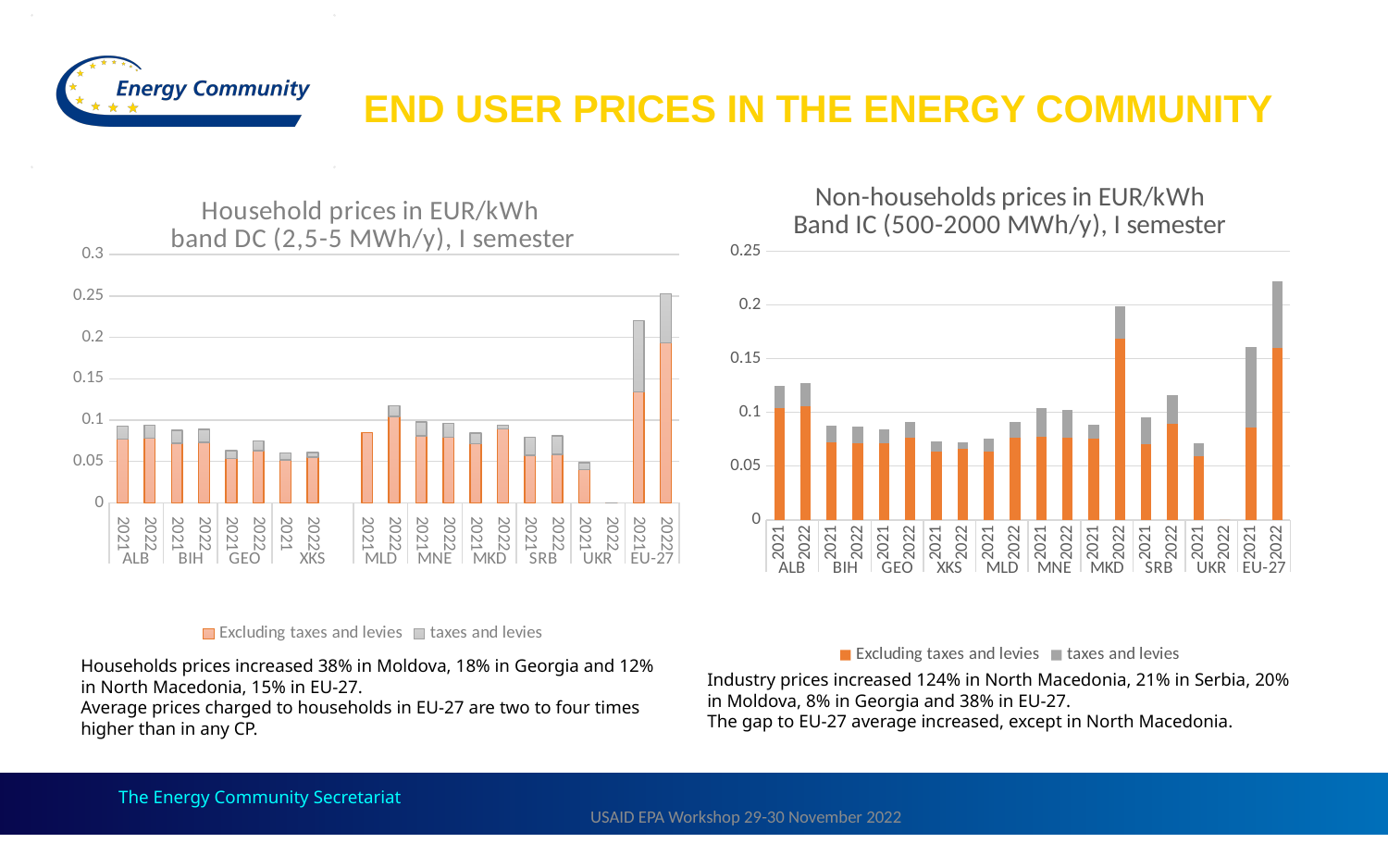
In the 'Non-households prices in EUR/kWh' chart, which total bar is larger: MKD 2022 or SRB 2022? MKD 2022 In the 'Non-households prices in EUR/kWh' chart, is the total value for XKS 2021 greater or less than 0.1? less How many countries/regions are shown on the x axis of the 'Household prices in EUR/kWh' chart? 10 In the 'Household prices in EUR/kWh' chart, which total bar is larger: MLD 2022 or GEO 2022? MLD 2022 In the 'Household prices in EUR/kWh' chart, which country and year has the highest total bar? EU-27 2022 What are the two legend entries of the 'Household prices in EUR/kWh' chart? Excluding taxes and levies; taxes and levies In the 'Household prices in EUR/kWh' chart, is the total value for XKS 2021 greater or less than 0.1? less In the 'Non-households prices in EUR/kWh' chart, is the total value for MKD 2022 greater or less than 0.15? greater How many series does the legend of the 'Non-households prices in EUR/kWh Band IC (500-2000 MWh/y), I semester' chart list? 2 In the 'Non-households prices in EUR/kWh' chart, which country and year has the highest total bar? EU-27 2022 What kind of chart is the 'Household prices in EUR/kWh band DC (2,5-5 MWh/y), I semester' chart? Stacked bar chart